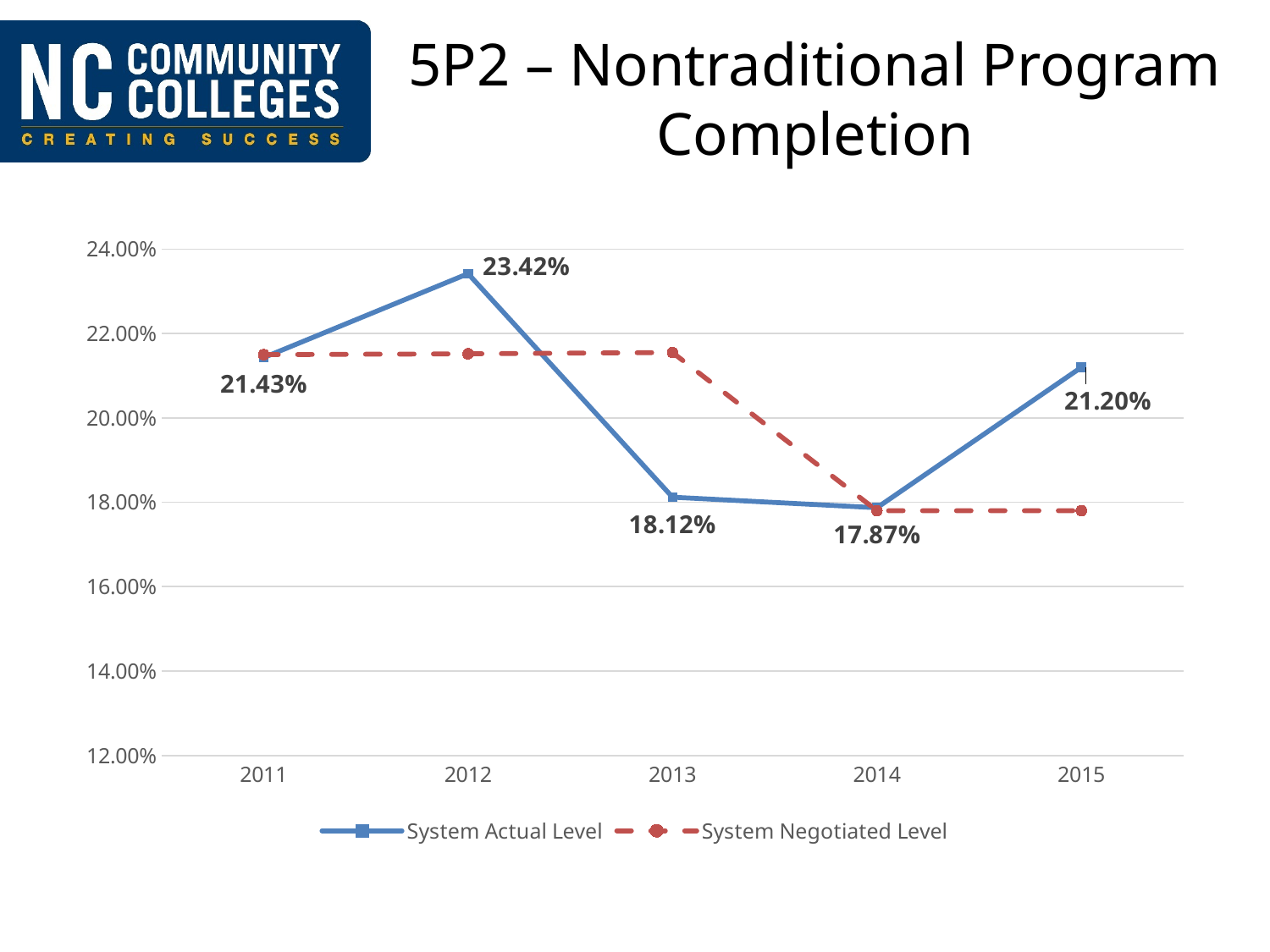
What is the System Actual Level for 2015? 21.20% How many series does the legend list? 2 What is the System Actual Level for 2012? 23.42% Which year has the larger System Actual Level, 2011 or 2015? 2011 Is the System Negotiated Level for 2015 greater or less than 20.00%? less What is the System Actual Level for 2014? 17.87% In which year is the System Actual Level lowest? 2014 What is the difference between the System Actual Level in 2012 and in 2013? 5.30% What kind of chart is shown on the slide? line chart In which year is the System Actual Level highest? 2012 Is the System Negotiated Level for 2013 greater or less than 20.00%? greater How many years are shown on the x axis? 5